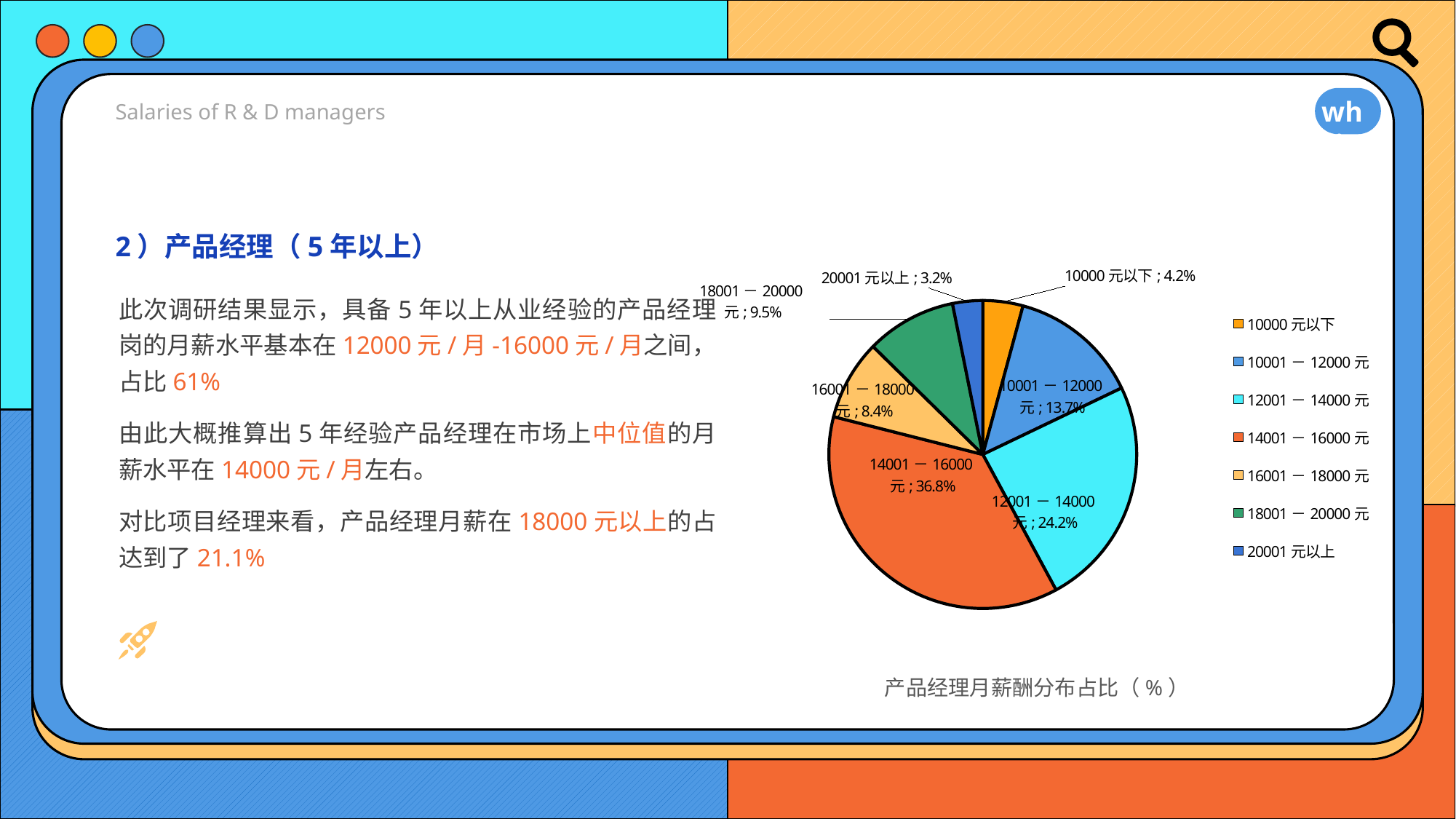
What colour is the 10000 元以下 slice in the pie chart? orange Which salary range has the largest share of the pie? 14001－16000 元 How many slices does the pie chart have? 7 What is the value shown for 18001－20000 元? 9.5% Which salary range has the smallest share of the pie? 20001 元以上 What is the difference between the shares for 14001－16000 元 and 12001－14000 元? 12.6% What share of the pie is the 14001－16000 元 slice? 36.8% What is the title of the chart? 产品经理月薪酬分布占比（%） What is the value shown for 10001－12000 元? 13.7% What is the value shown for 12001－14000 元? 24.2% What kind of chart is shown on the slide? pie chart Which is larger, the share for 16001－18000 元 or the share for 18001－20000 元? 18001－20000 元